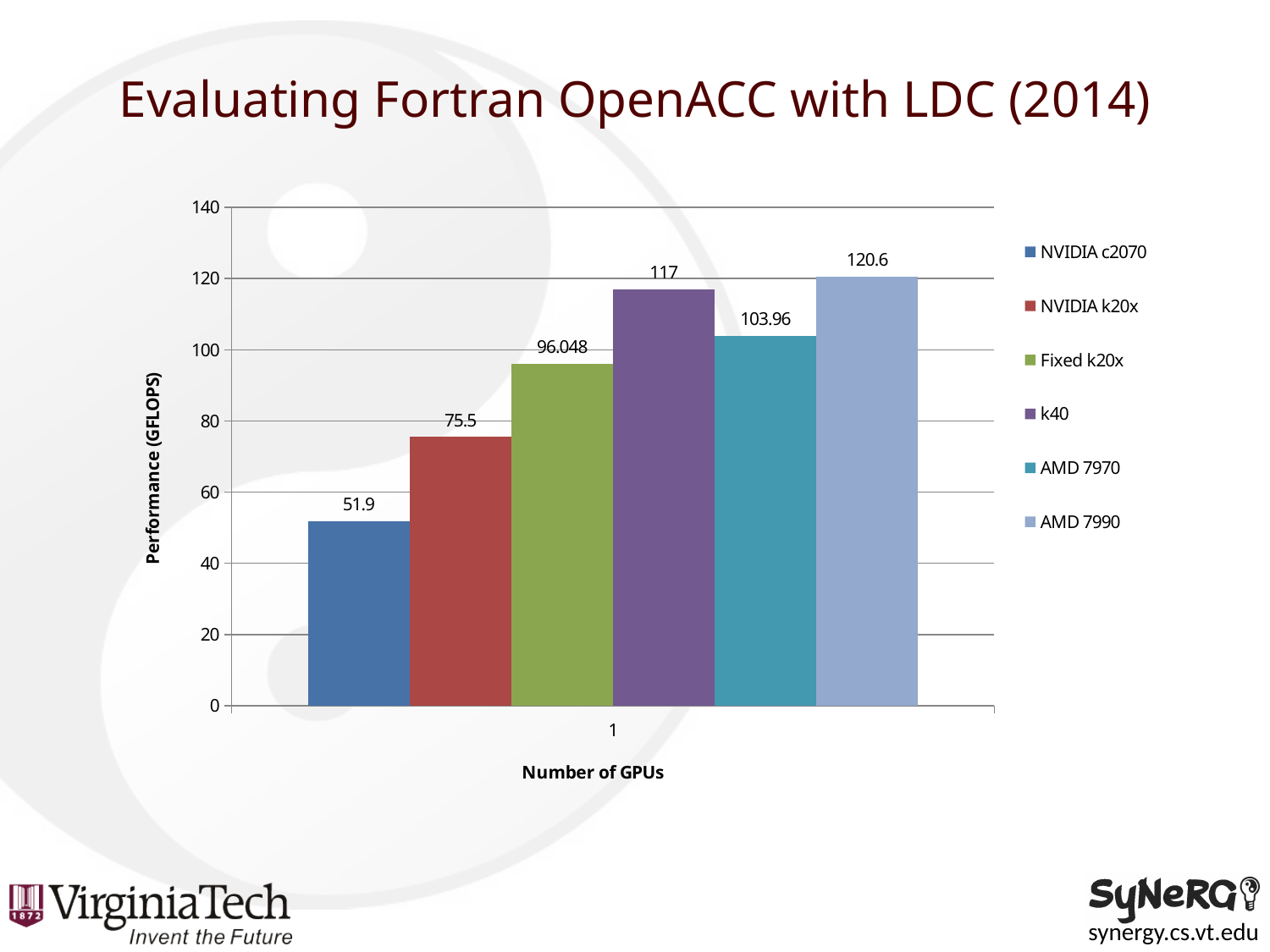
What is the performance value for NVIDIA c2070? 51.9 What kind of chart is shown on the slide? bar chart What is the difference in performance between k40 and NVIDIA k20x? 41.5 What is the label of the y axis? Performance (GFLOPS) Which series has the highest performance? AMD 7990 Is the value for NVIDIA k20x greater or less than 80? less What is the difference in performance between AMD 7990 and NVIDIA c2070? 68.7 How many series does the legend list? 6 What is the performance value for Fixed k20x? 96.048 What is the performance value for AMD 7970? 103.96 Which has a higher performance value, k40 or AMD 7970? k40 Which series has the lowest performance? NVIDIA c2070